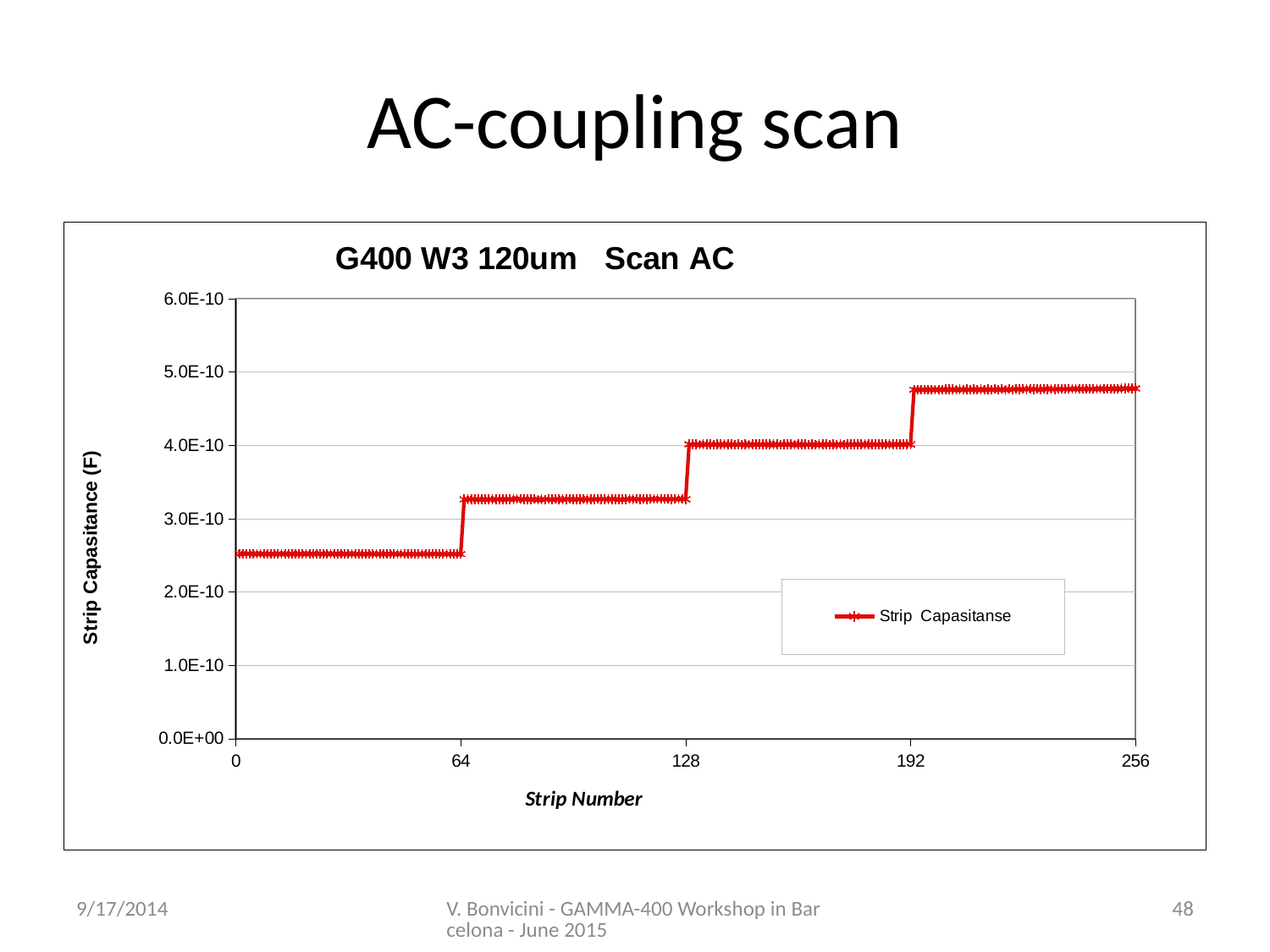
Do the strip capacitance values rise or fall as the strip number increases? rise What kind of chart is shown on the slide? line chart Which has the larger strip capacitance, strip number 100 or strip number 200? strip number 200 How many series does the legend list? 1 Is the strip capacitance at strip number 32 greater or less than 2.0E-10? greater Is the strip capacitance at strip number 100 greater or less than 3.0E-10? greater What is the name of the series shown in the legend? Strip Capasitanse Is the strip capacitance at strip number 224 greater or less than 5.0E-10? less How many distinct plateau levels does the strip capacitance curve show across the strip range? 4 What is the title of the chart? G400 W3 120um Scan AC